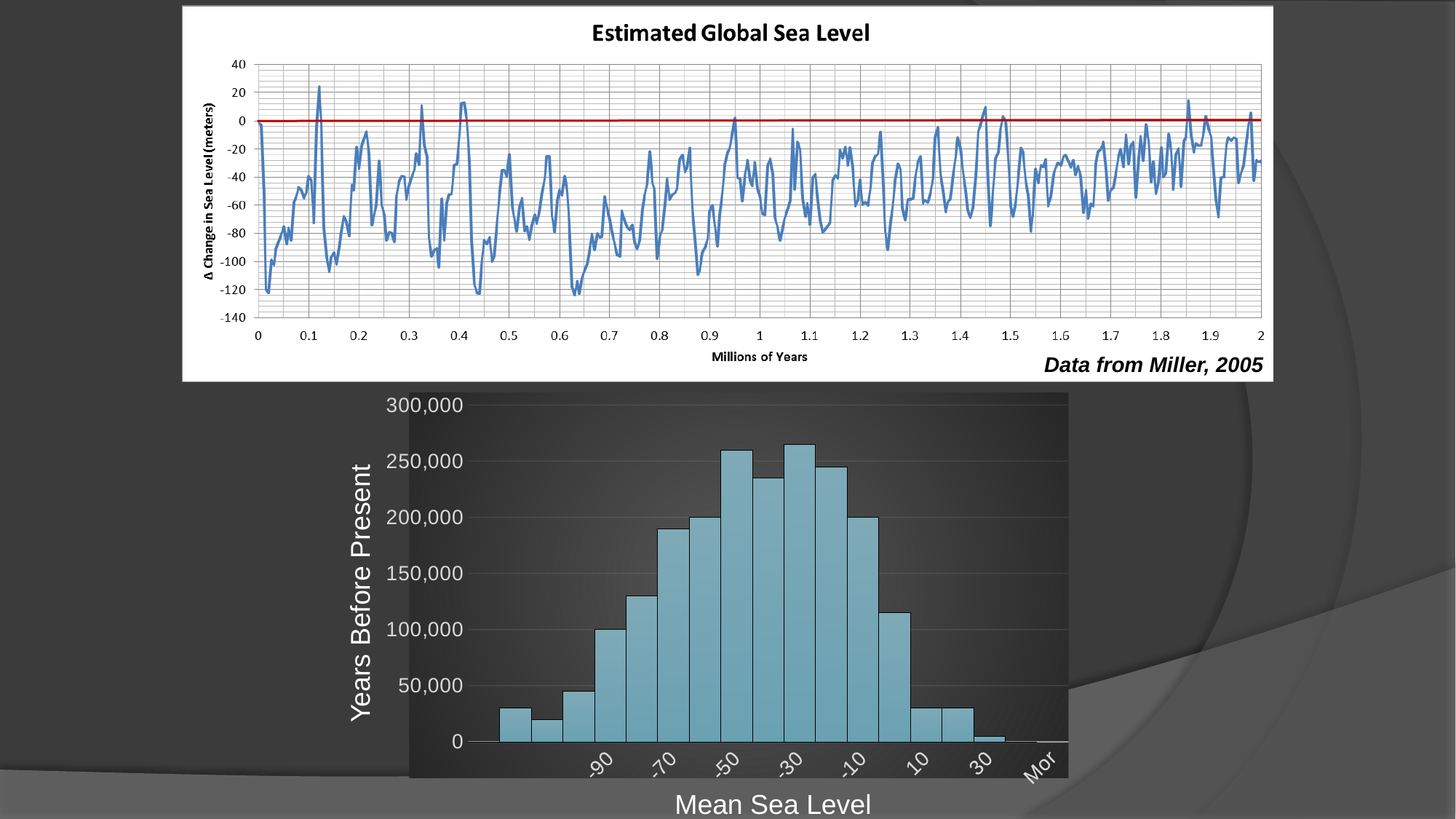
In the bottom chart, is the value for the -50 bin greater or less than 200,000? greater In the top chart 'Estimated Global Sea Level', is the value at about 0.63 million years greater or less than -100? less In the bottom chart, is the value for the -10 bin greater or less than 250,000? less What is the title of the top chart? Estimated Global Sea Level In the bottom chart, which bin has the larger value, -50 or 10? -50 What is the y-axis label of the bottom chart? Years Before Present What type of chart is the top chart titled 'Estimated Global Sea Level'? line chart What type of chart is the bottom chart with the x-axis 'Mean Sea Level'? bar chart